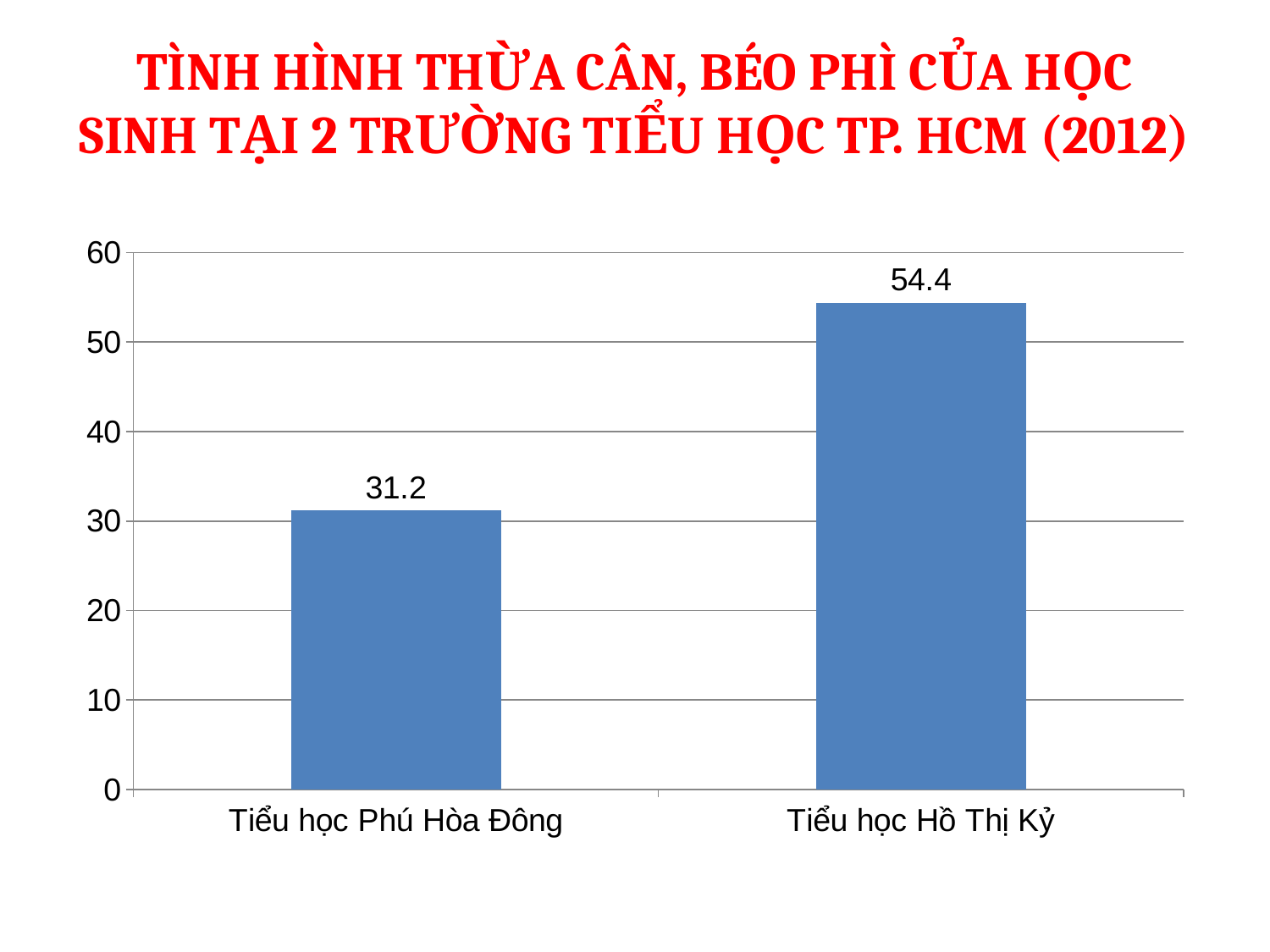
Is the value for Tiểu học Phú Hòa Đông greater or less than 40? less What is the value for Tiểu học Hồ Thị Kỷ? 54.4 How many schools are shown on the chart? 2 What colour are the bars in the chart? blue Which is larger, the value for Tiểu học Phú Hòa Đông or the value for Tiểu học Hồ Thị Kỷ? Tiểu học Hồ Thị Kỷ What kind of chart is shown on the slide? bar chart What is the difference between the values for Tiểu học Hồ Thị Kỷ and Tiểu học Phú Hòa Đông? 23.2 What is the maximum value shown on the vertical axis? 60 Is the value for Tiểu học Hồ Thị Kỷ greater or less than 50? greater Which school has the highest value? Tiểu học Hồ Thị Kỷ What is the value for Tiểu học Phú Hòa Đông? 31.2 Which school has the lowest value? Tiểu học Phú Hòa Đông